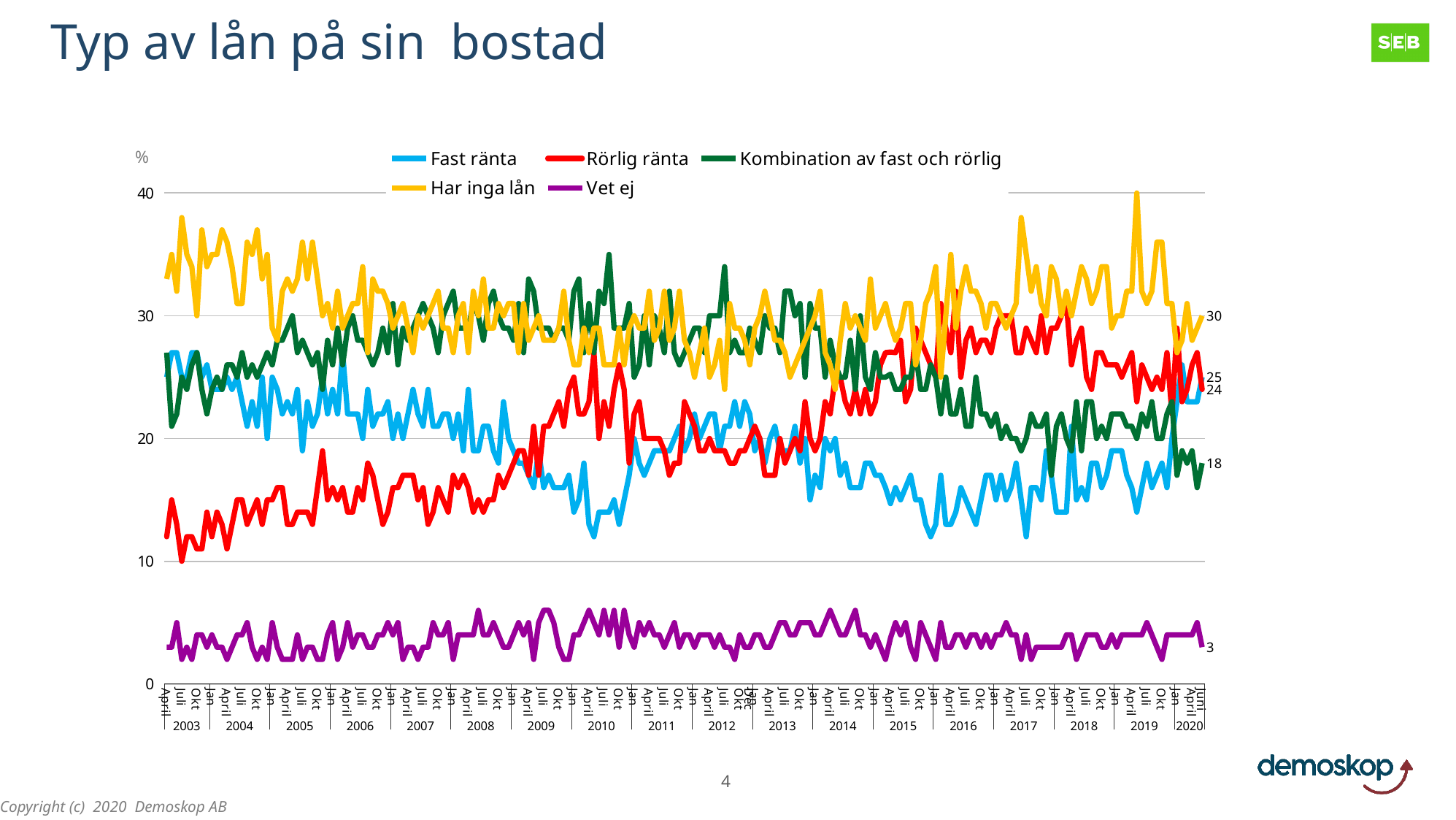
What is the latest (2020) value for Rörlig ränta? 24 What is the difference between the 2020 end values of Har inga lån and Kombination av fast och rörlig? 12 What kind of chart is shown on the slide? line chart Does Rörlig ränta generally rise or fall from 2003 to 2020? rise What is the latest (2020) value for Har inga lån? 30 What is the latest (2020) value for Kombination av fast och rörlig? 18 Which series has the lowest value at the end of the chart in 2020? Vet ej What is the title of the chart on the slide? Typ av lån på sin bostad Which series has the highest value at the end of the chart in 2020? Har inga lån What is the latest (2020) value for Fast ränta? 25 How many series does the legend list? 5 What is the latest (2020) value for Vet ej? 3